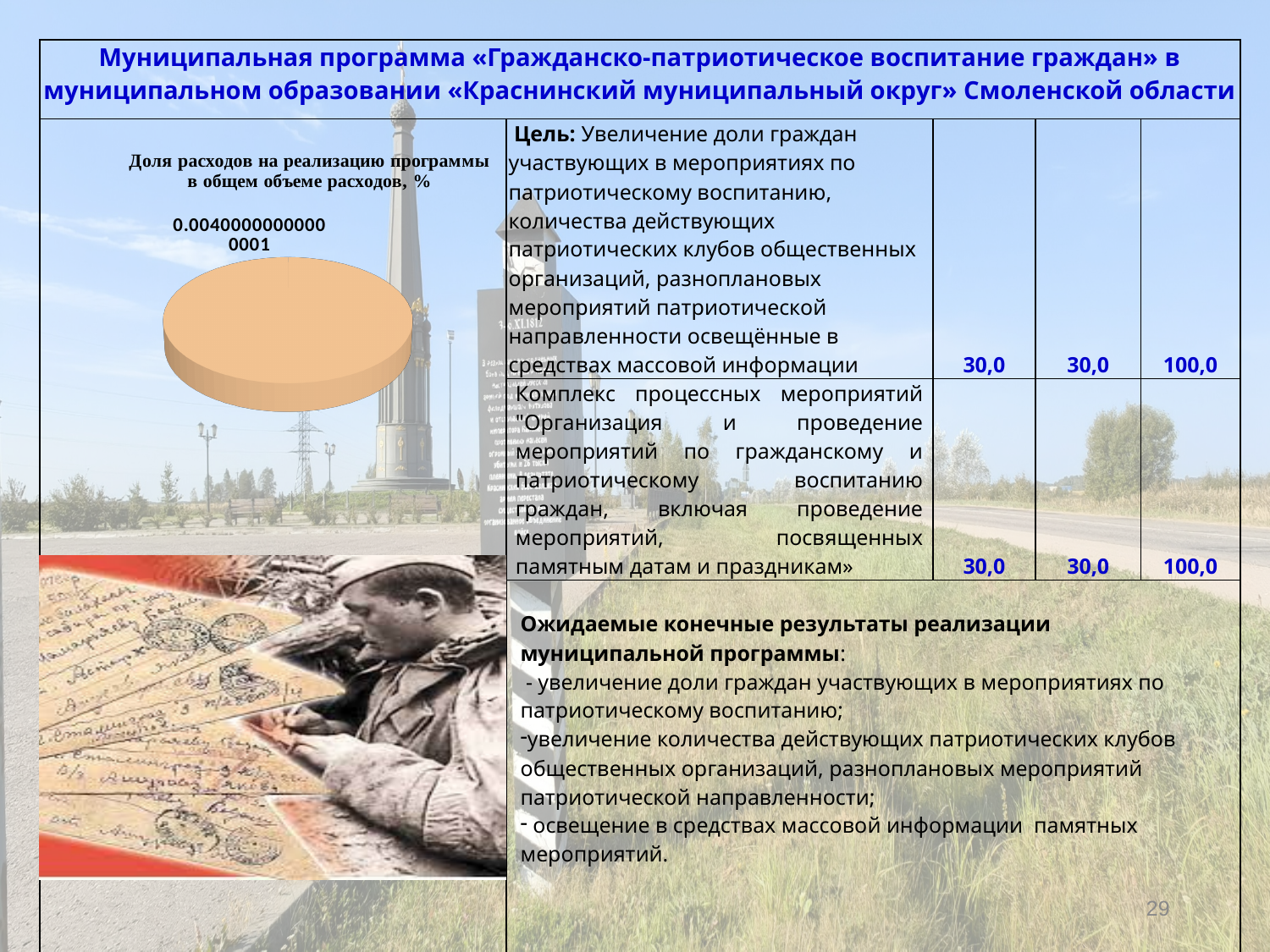
What colour is the slice of the pie chart on the left of the slide? orange What kind of chart is shown on the left of the slide? pie chart What value is printed as the data label on the pie chart on the left of the slide? 0.00400000000000001 What is the title of the pie chart on the left of the slide? Доля расходов на реализацию программы в общем объеме расходов, %